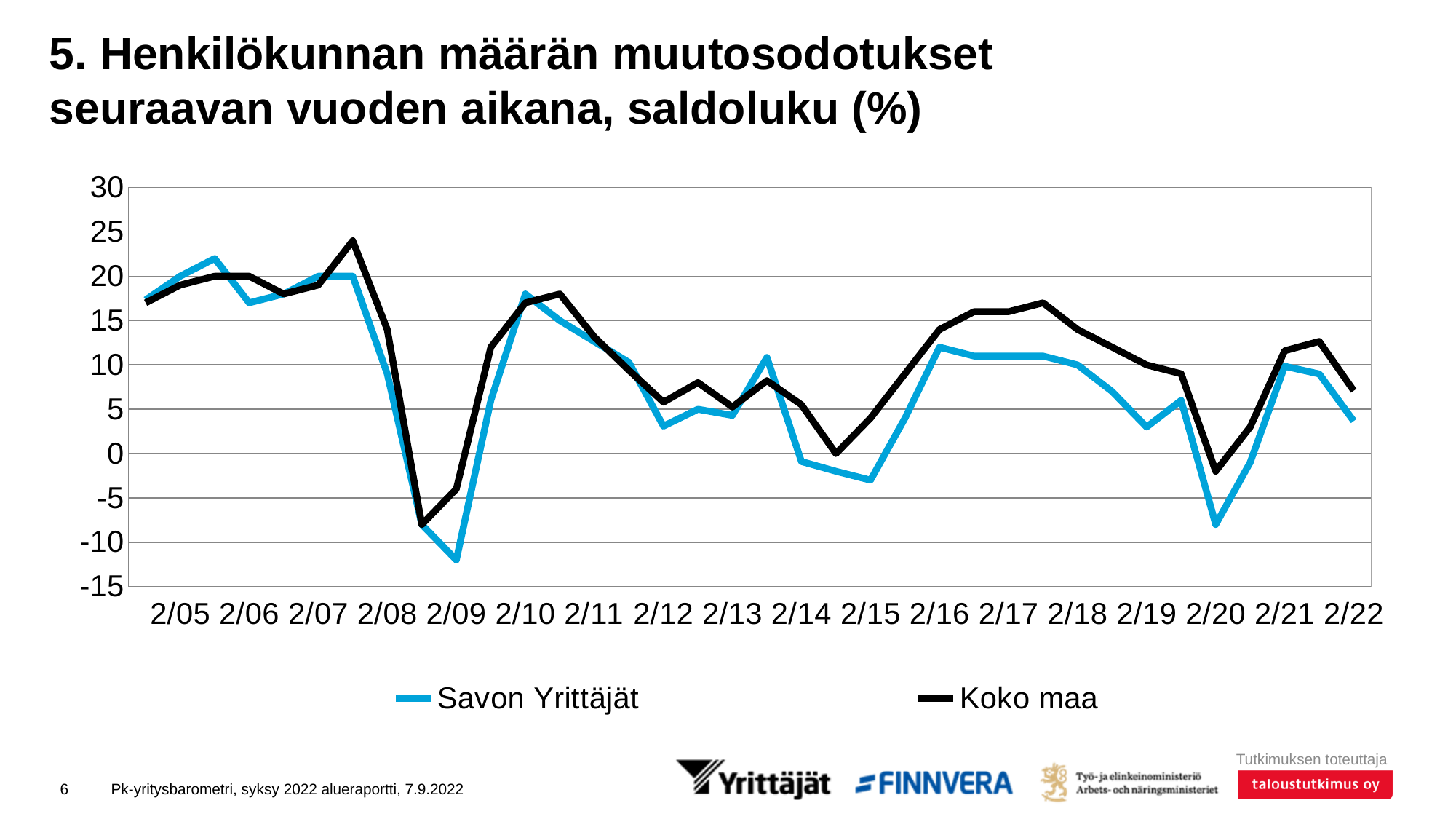
How many labels are shown on the x axis? 18 How many series does the legend list? 2 Is the value for Savon Yrittäjät at 2/20 greater or less than -5? less Is the value for Koko maa at 2/22 greater or less than 5? greater Which series reaches the lowest value anywhere on the chart? Savon Yrittäjät At 2/09, which series has the lower value, Savon Yrittäjät or Koko maa? Savon Yrittäjät Is the value for Savon Yrittäjät at 2/09 greater or less than -10? less Which two series are listed in the legend? Savon Yrittäjät and Koko maa At 2/22, which series has the higher value, Savon Yrittäjät or Koko maa? Koko maa Do the values for Koko maa rise or fall from 2/21 to 2/22? fall What kind of chart is shown on the slide? line chart